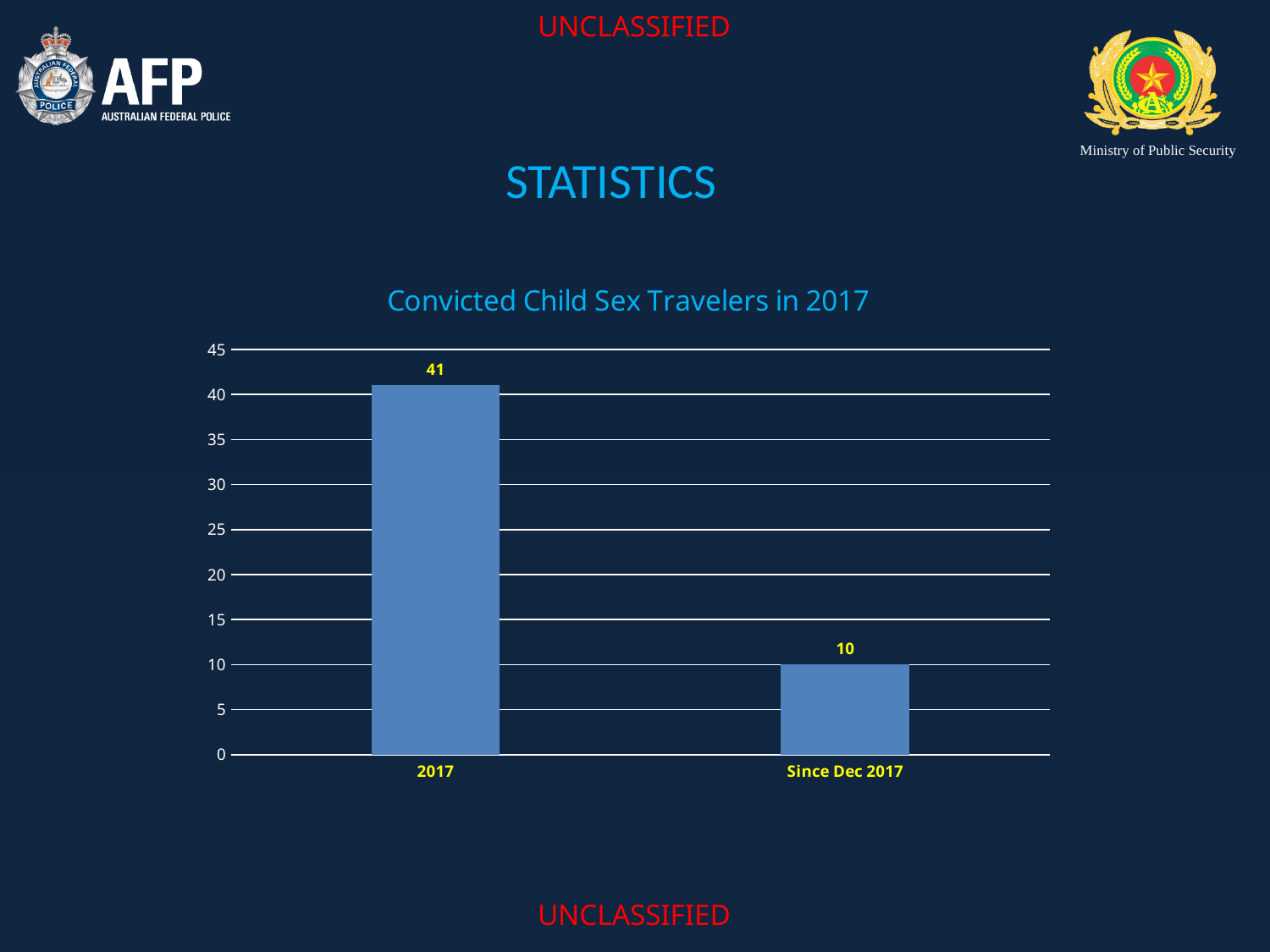
Is the value for 2017 greater or less than 35? greater What is the value for Since Dec 2017? 10 What kind of chart is shown on the slide? bar chart Is the value for Since Dec 2017 greater or less than 15? less Do the values rise or fall from left to right along the x axis? fall Which is larger, the value for 2017 or the value for Since Dec 2017? 2017 What is the difference between the values for 2017 and Since Dec 2017? 31 What is the value for 2017? 41 Which category has the lowest value? Since Dec 2017 How many categories are shown on the x axis? 2 What is the title of the chart? Convicted Child Sex Travelers in 2017 Which category has the highest value? 2017